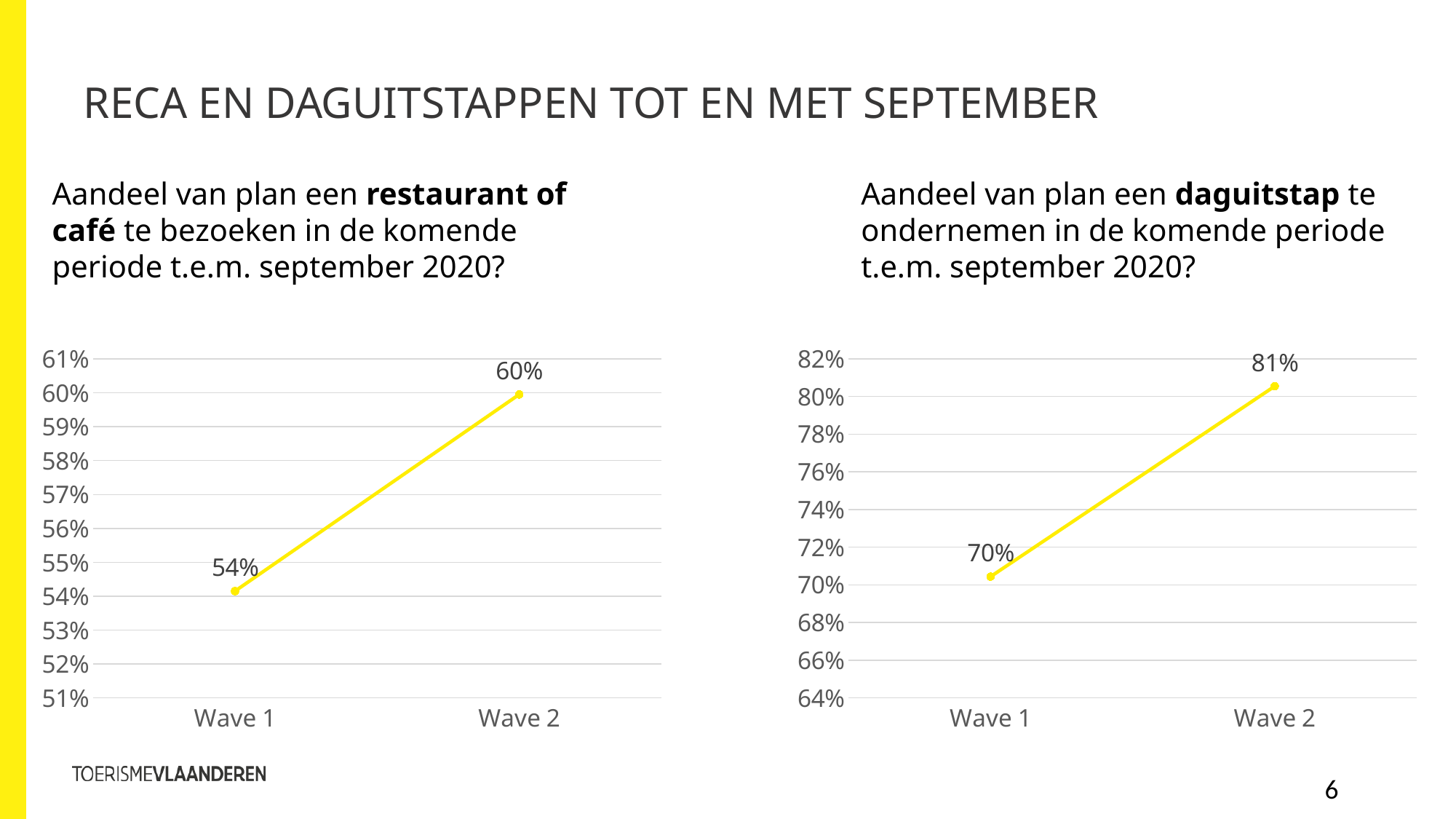
In the left chart (restaurant of café), what is the value for Wave 1? 54% In the right chart (daguitstap), which wave has the higher value? Wave 2 In the left chart (restaurant of café), what is the difference between Wave 2 and Wave 1? 6% In the right chart (daguitstap), what is the value for Wave 1? 70% In the right chart (daguitstap), what is the difference between Wave 2 and Wave 1? 11% How many data points are plotted in the left chart (restaurant of café)? 2 In the left chart (restaurant of café), what is the value for Wave 2? 60% What kind of chart is the right chart (daguitstap)? line chart In the left chart (restaurant of café), which wave has the lower value? Wave 1 In the right chart (daguitstap), what is the value for Wave 2? 81% What colour is the line in the right chart (daguitstap)? yellow In the left chart (restaurant of café), do the values rise or fall from Wave 1 to Wave 2? rise